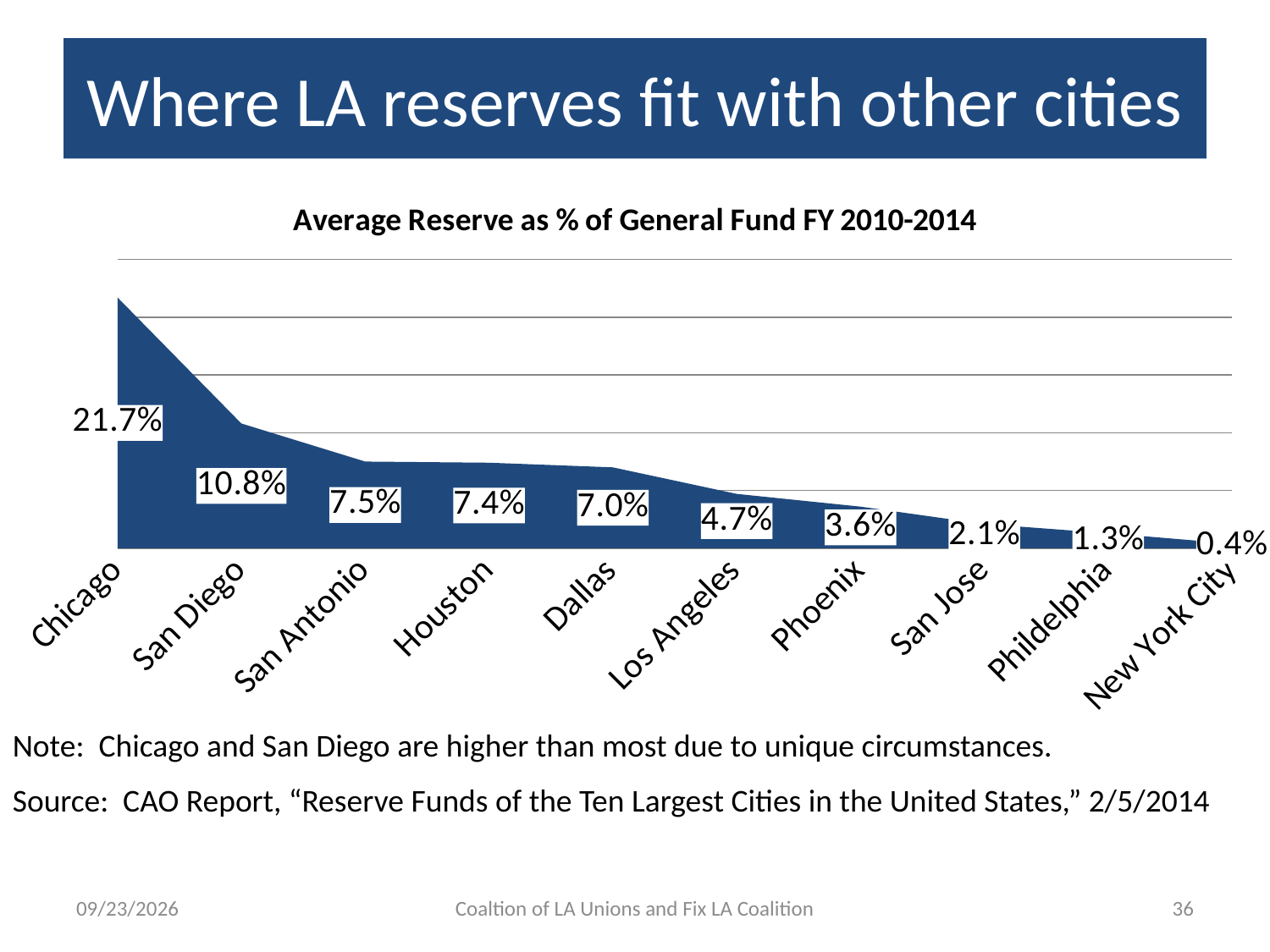
What is the difference between San Diego's value and Los Angeles's value? 6.1% What is the value shown for Houston? 7.4% Which has a larger value, Dallas or Los Angeles? Dallas What is the difference between Chicago's value and San Diego's value? 10.9% What is the average reserve as % of general fund for Los Angeles? 4.7% Which city has the lowest average reserve as % of general fund? New York City What is the value shown for Chicago? 21.7% How many cities are shown in the chart? 10 Do the values rise or fall moving from left to right along the x axis? Fall Which has a larger value, Phoenix or San Jose? Phoenix Which city has the highest average reserve as % of general fund? Chicago What kind of chart is shown on the slide? Area chart